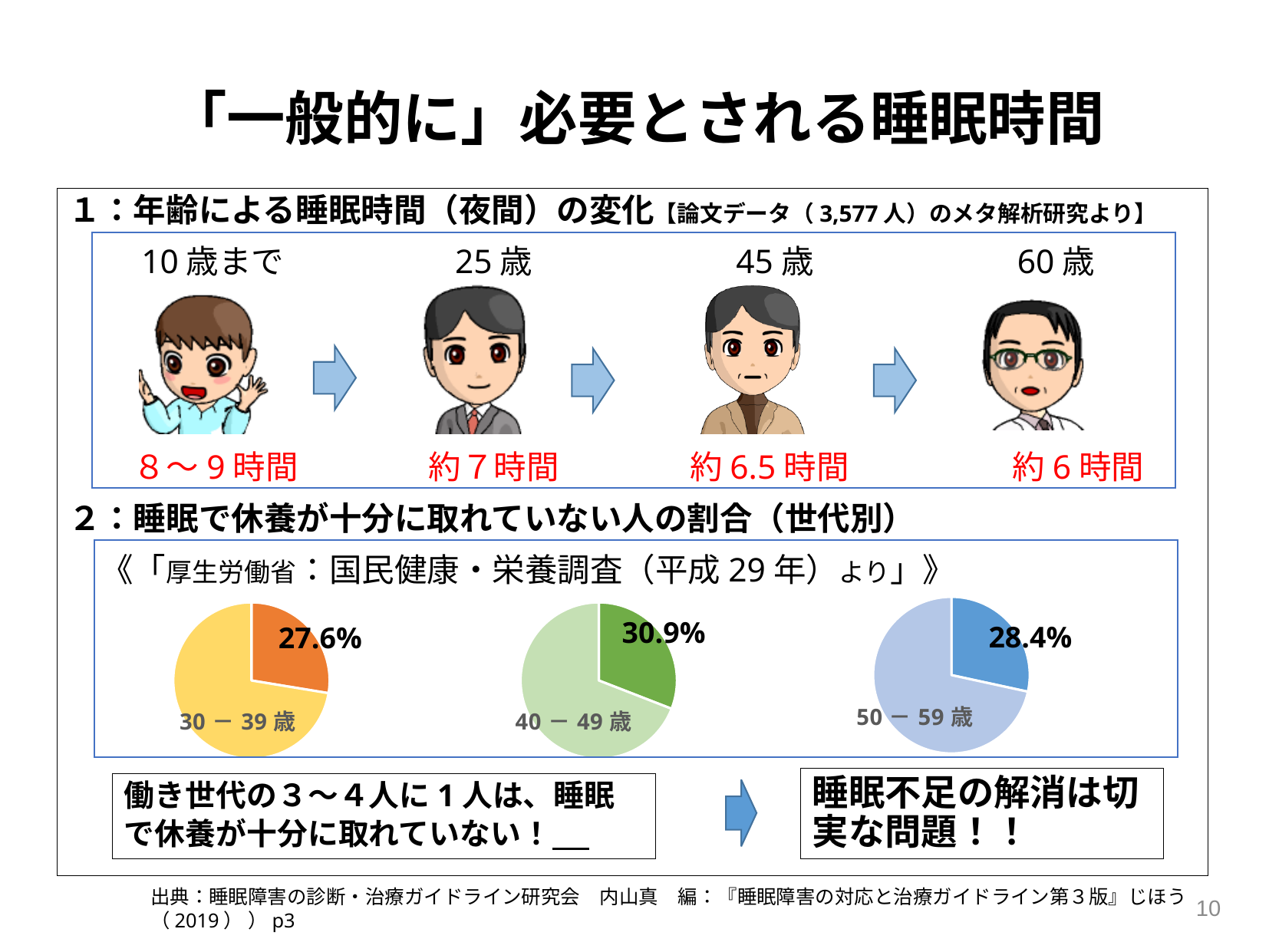
In the pie chart for 40－49歳, what percentage is shown for the highlighted slice? 30.9% In the pie chart for 50－59歳, what percentage is shown for the highlighted slice? 28.4% Which age group's pie chart shows the lowest percentage of people not getting enough rest from sleep? 30－39歳 What is the difference between the percentage shown for 40－49歳 and the percentage shown for 30－39歳? 3.3% Which is larger: the percentage shown for 40－49歳 or the percentage shown for 50－59歳? 40－49歳 In the pie chart for 30－39歳, what percentage of people are not getting enough rest from sleep? 27.6% What colour is the highlighted slice in the pie chart for 50－59歳? Blue How many slices does each pie chart have? 2 How many pie charts are shown on the slide? 3 What is the difference between the percentage shown for 50－59歳 and the percentage shown for 30－39歳? 0.8% What kind of chart is used to show the share of people not getting enough rest from sleep for each age group? Pie chart Which age group's pie chart shows the highest percentage of people not getting enough rest from sleep? 40－49歳